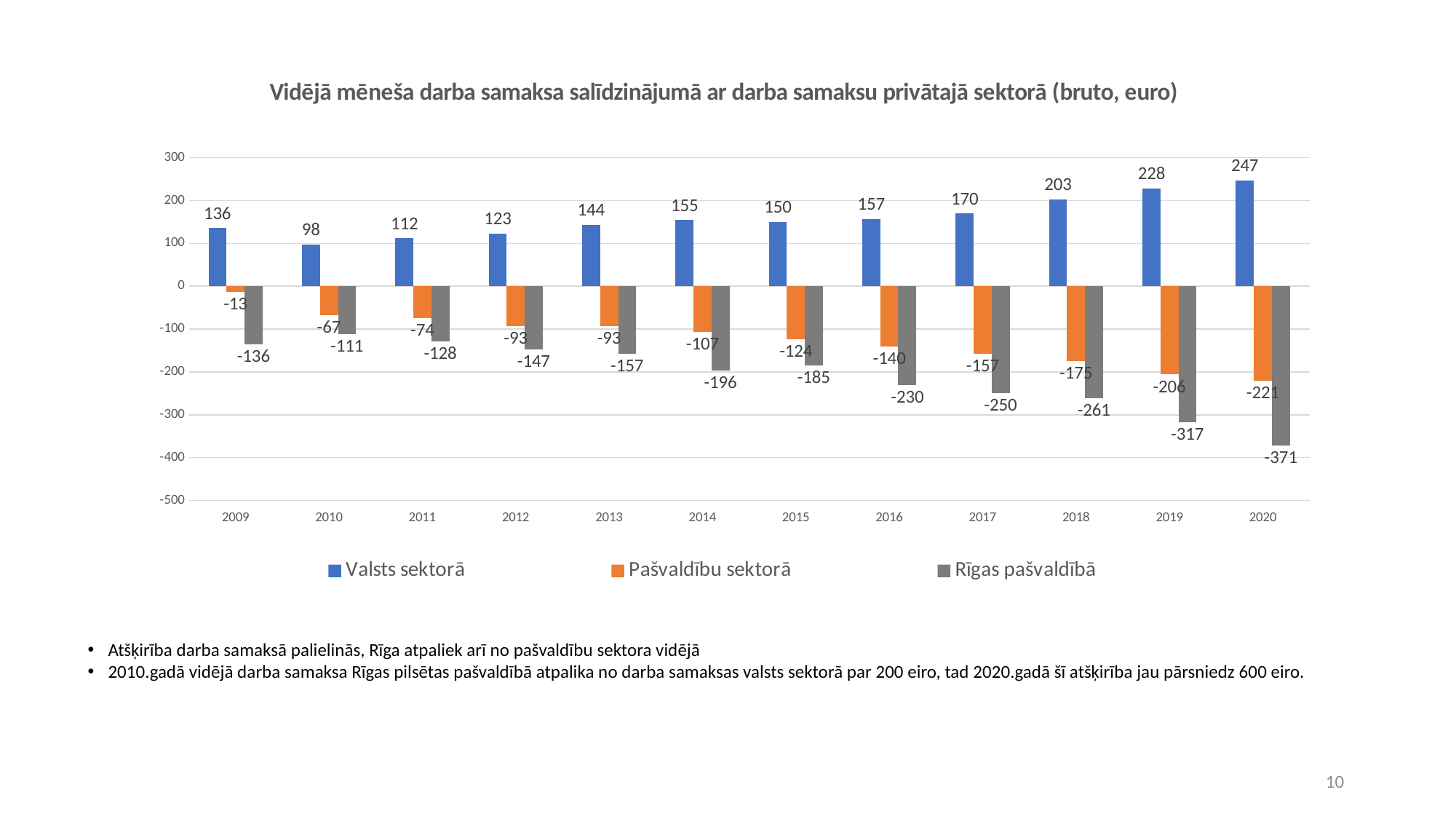
What is the difference between the Valsts sektorā values in 2020 and 2010? 149 What kind of chart is shown on the slide? Bar chart What is the value for Valsts sektorā in 2020? 247 How many series does the legend list? 3 In which year is the Rīgas pašvaldībā value lowest? 2020 Do the Rīgas pašvaldībā values rise or fall from 2009 to 2020? Fall What is the value for Rīgas pašvaldībā in 2014? -196 In which year is the Valsts sektorā value lowest? 2010 How many years are shown on the x axis? 12 Which is larger in 2013: the Pašvaldību sektorā value or the Rīgas pašvaldībā value? Pašvaldību sektorā What is the value for Pašvaldību sektorā in 2017? -157 In which year is the Valsts sektorā value highest? 2020